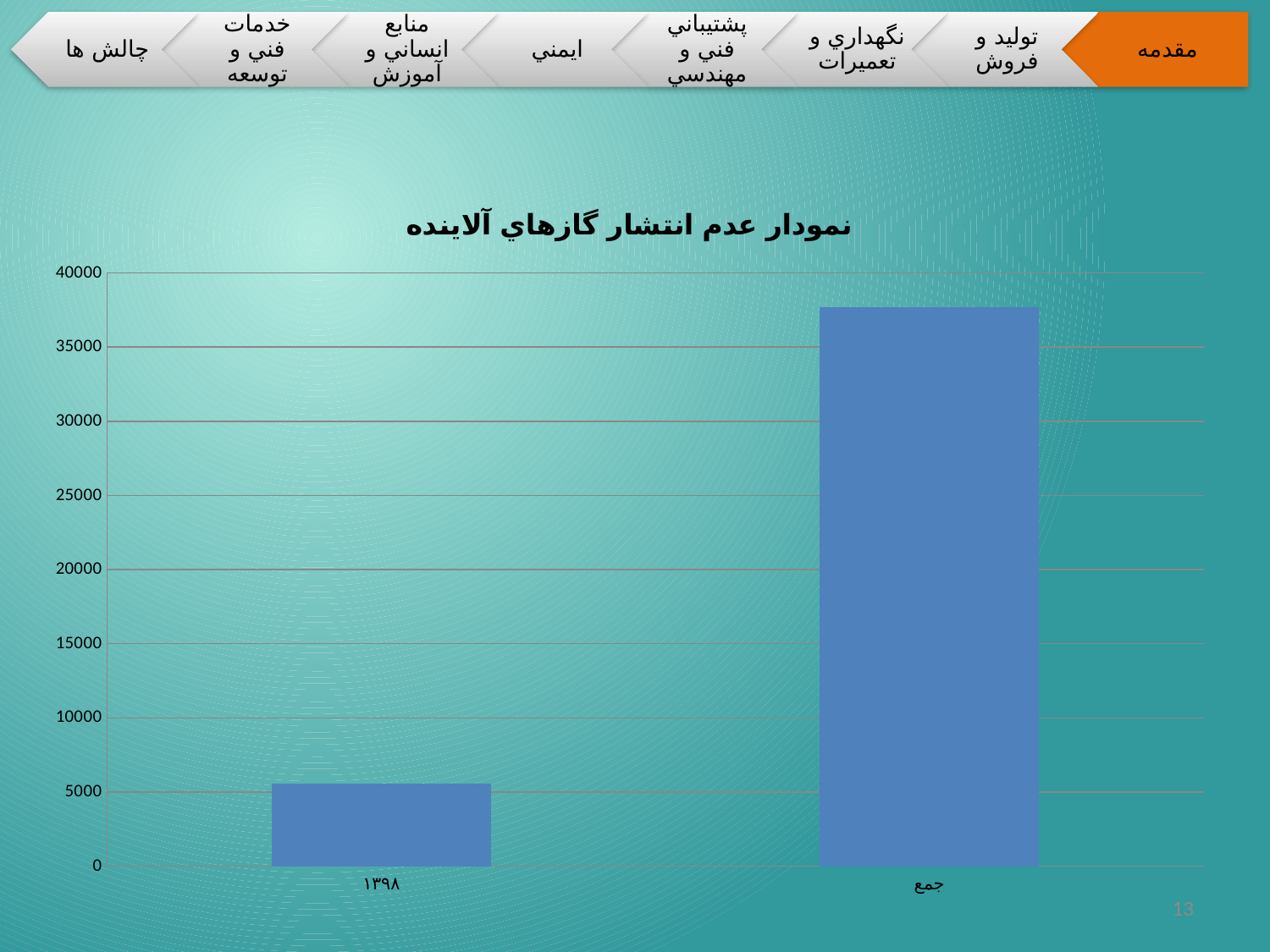
Is the value for جمع greater or less than 40000? less Which is larger, the value for ۱۳۹۸ or the value for جمع? جمع What kind of chart is shown on the slide? bar chart Is the value for ۱۳۹۸ greater or less than 10000? less Is the value for ۱۳۹۸ greater or less than 5000? greater Which category has the highest bar? جمع Which category has the lowest bar? ۱۳۹۸ What is the highest value shown on the vertical axis? 40000 How many bars are plotted in the chart? 2 What is the title of the chart? نمودار عدم انتشار گازهاي آلاينده